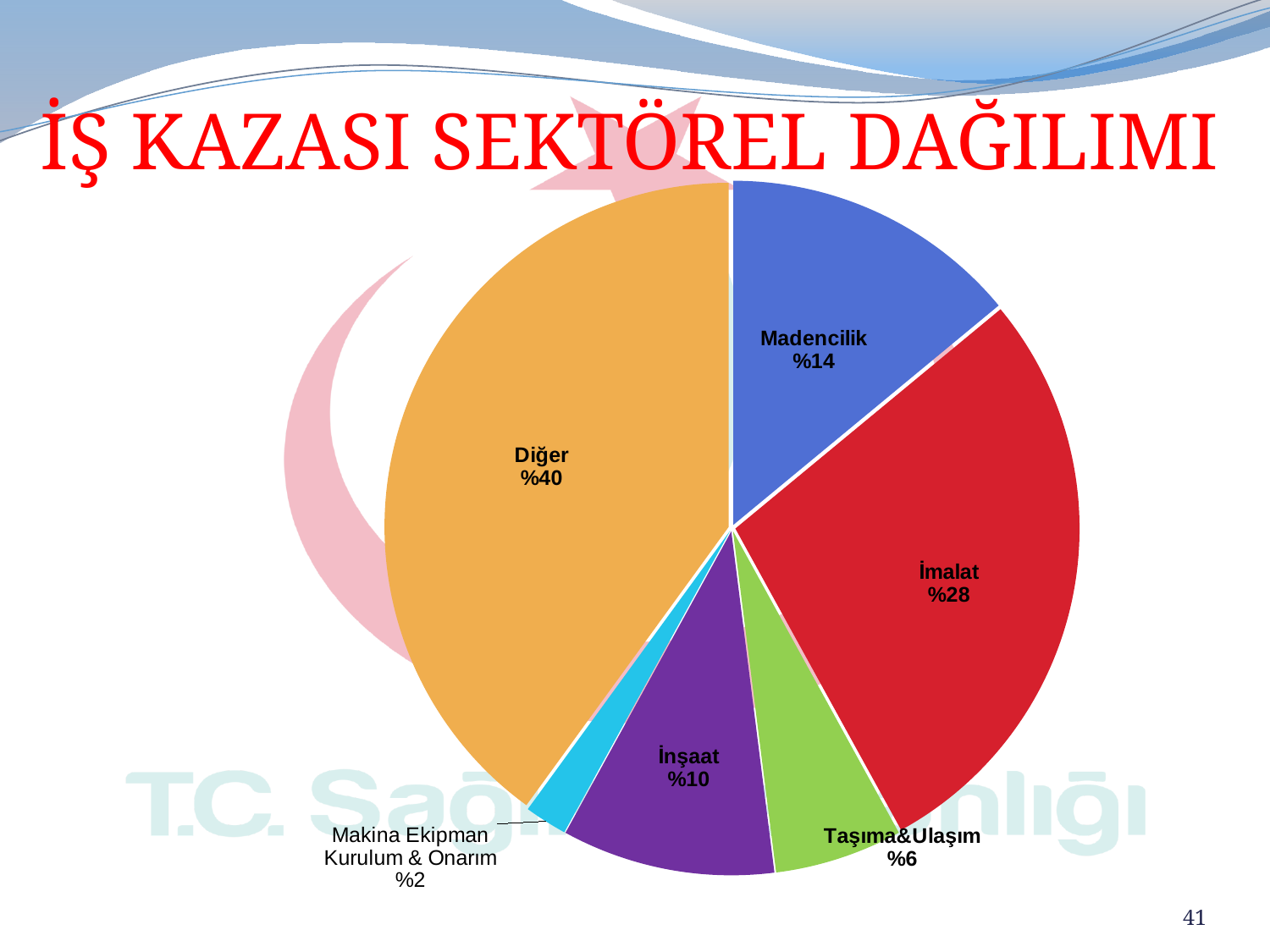
What kind of chart is shown on the slide? pie chart How many slices does the pie chart have? 6 Which slice of the pie is the largest? Diğer What share of the pie does İmalat have? %28 What share of the pie does Makina Ekipman Kurulum & Onarım have? %2 What is the difference between the shares of İmalat and Madencilik? %14 Which is larger, the share of Taşıma&Ulaşım or the share of İnşaat? İnşaat What share of the pie does İnşaat have? %10 Which slice of the pie is the smallest? Makina Ekipman Kurulum & Onarım What is the title of the chart on the slide? İŞ KAZASI SEKTÖREL DAĞILIMI What share of the pie does Madencilik have? %14 What colour is the Diğer slice of the pie? orange